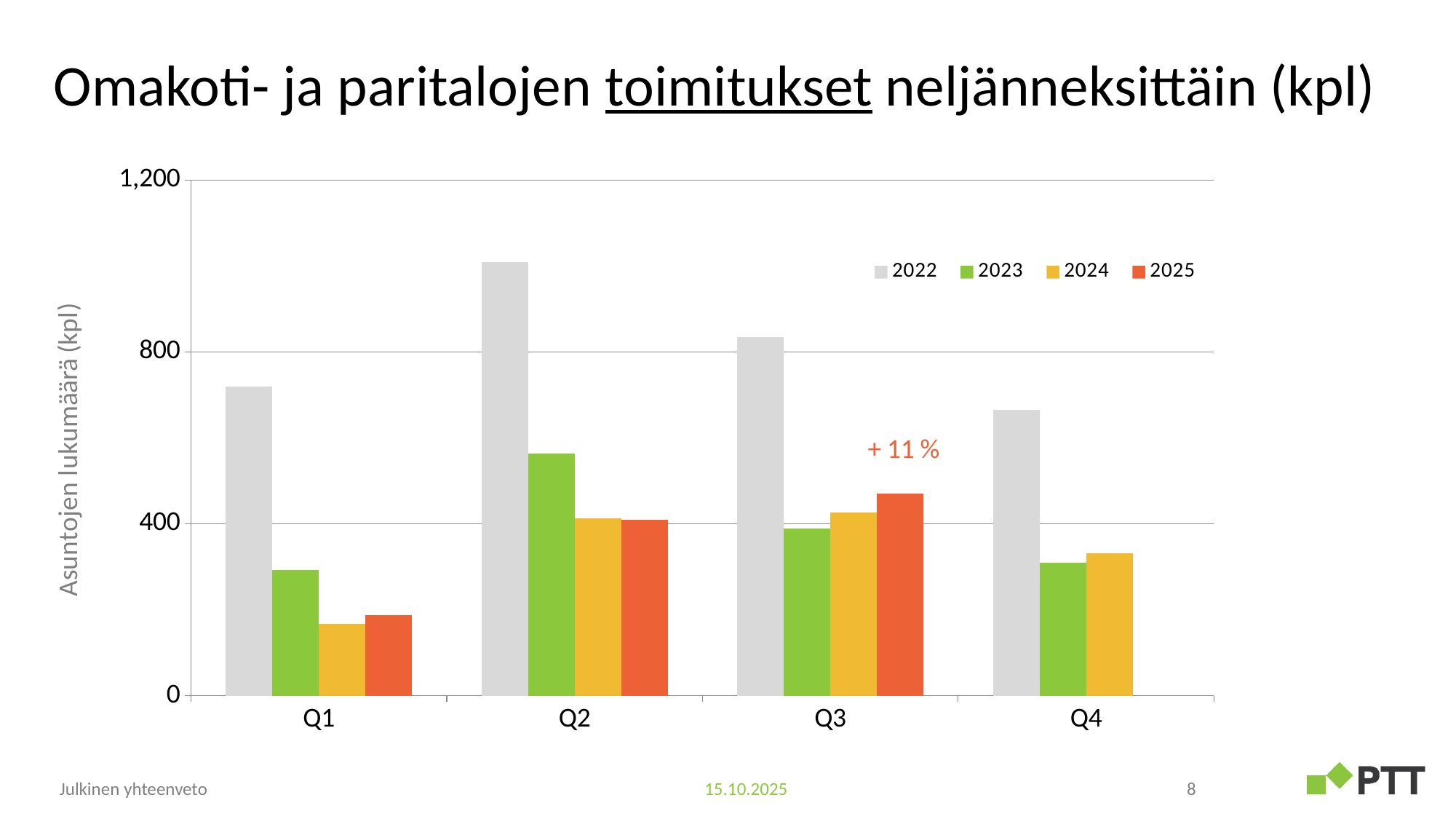
In Q2, which is larger: the 2023 value or the 2024 value? 2023 How many quarters are shown on the x axis? 4 In which quarter is the 2023 value highest? Q2 In which quarter is the 2022 value highest? Q2 How many series does the legend list? 4 What kind of chart is shown on the slide? bar chart In which quarter is the 2022 value lowest? Q4 Is the 2022 value for Q2 greater or less than 800? greater What percentage change annotation is printed above the Q3 bars? + 11 % Is the 2025 value for Q3 greater or less than 400? greater Is the 2023 value for Q1 greater or less than 400? less In which quarter is the 2024 value lowest? Q1